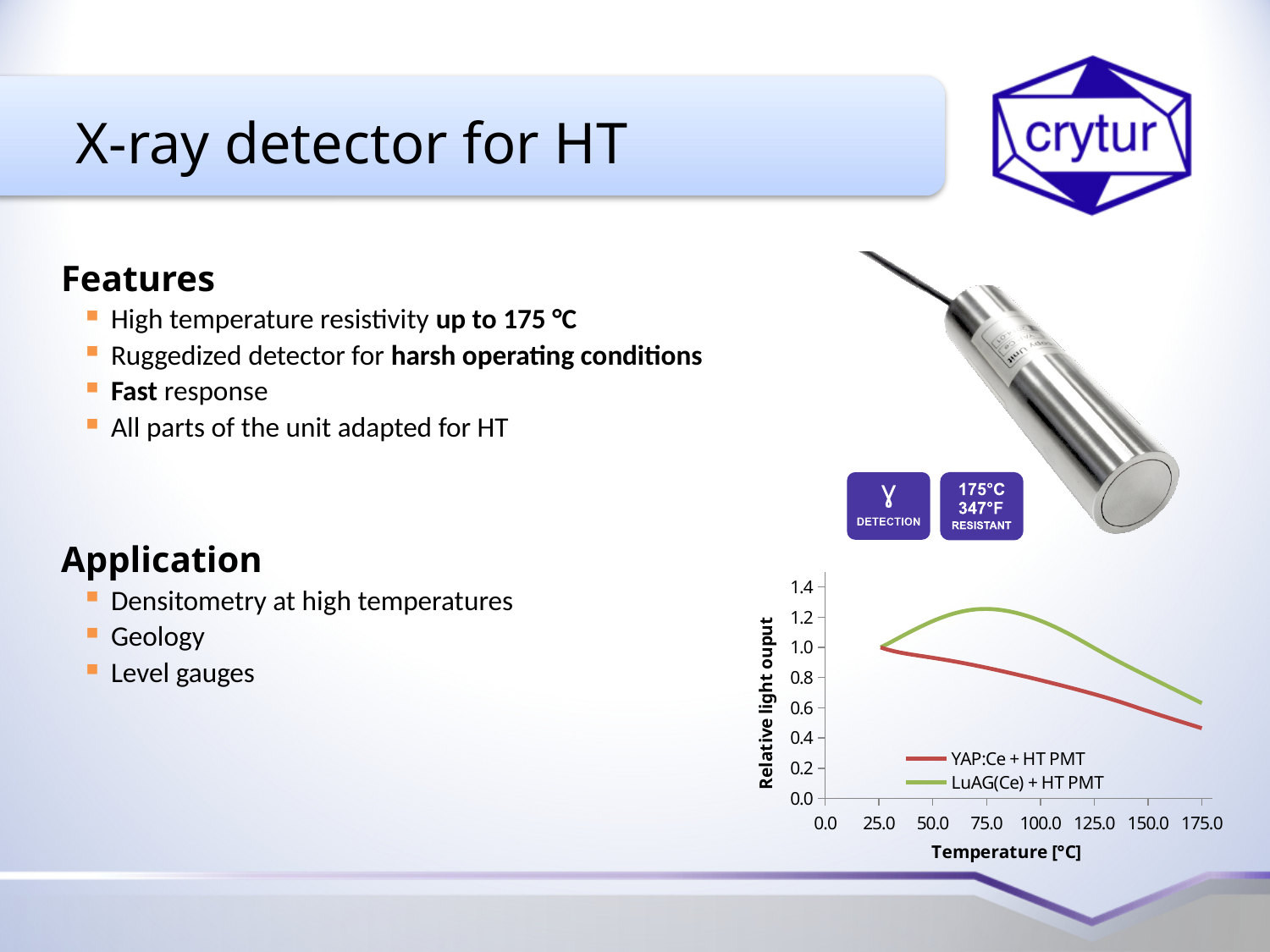
Does the relative light output of LuAG(Ce) + HT PMT rise or fall as temperature increases from 75.0 °C to 175.0 °C? fall What kind of chart is shown on the slide? line chart At 125.0 °C, which series has the lower relative light output, YAP:Ce + HT PMT or LuAG(Ce) + HT PMT? YAP:Ce + HT PMT How many series does the chart legend list? 2 Is the relative light output of LuAG(Ce) + HT PMT at 75.0 °C greater or less than 1.0? greater What are the two series named in the chart legend? YAP:Ce + HT PMT and LuAG(Ce) + HT PMT Is the relative light output of YAP:Ce + HT PMT at 100.0 °C greater or less than 0.6? greater Is the relative light output of LuAG(Ce) + HT PMT at 175.0 °C greater or less than 0.8? less What is the title of the chart's x axis? Temperature [°C] Does the relative light output of YAP:Ce + HT PMT rise or fall as temperature increases from 25.0 °C to 175.0 °C? fall At 175.0 °C, which series has the higher relative light output, YAP:Ce + HT PMT or LuAG(Ce) + HT PMT? LuAG(Ce) + HT PMT